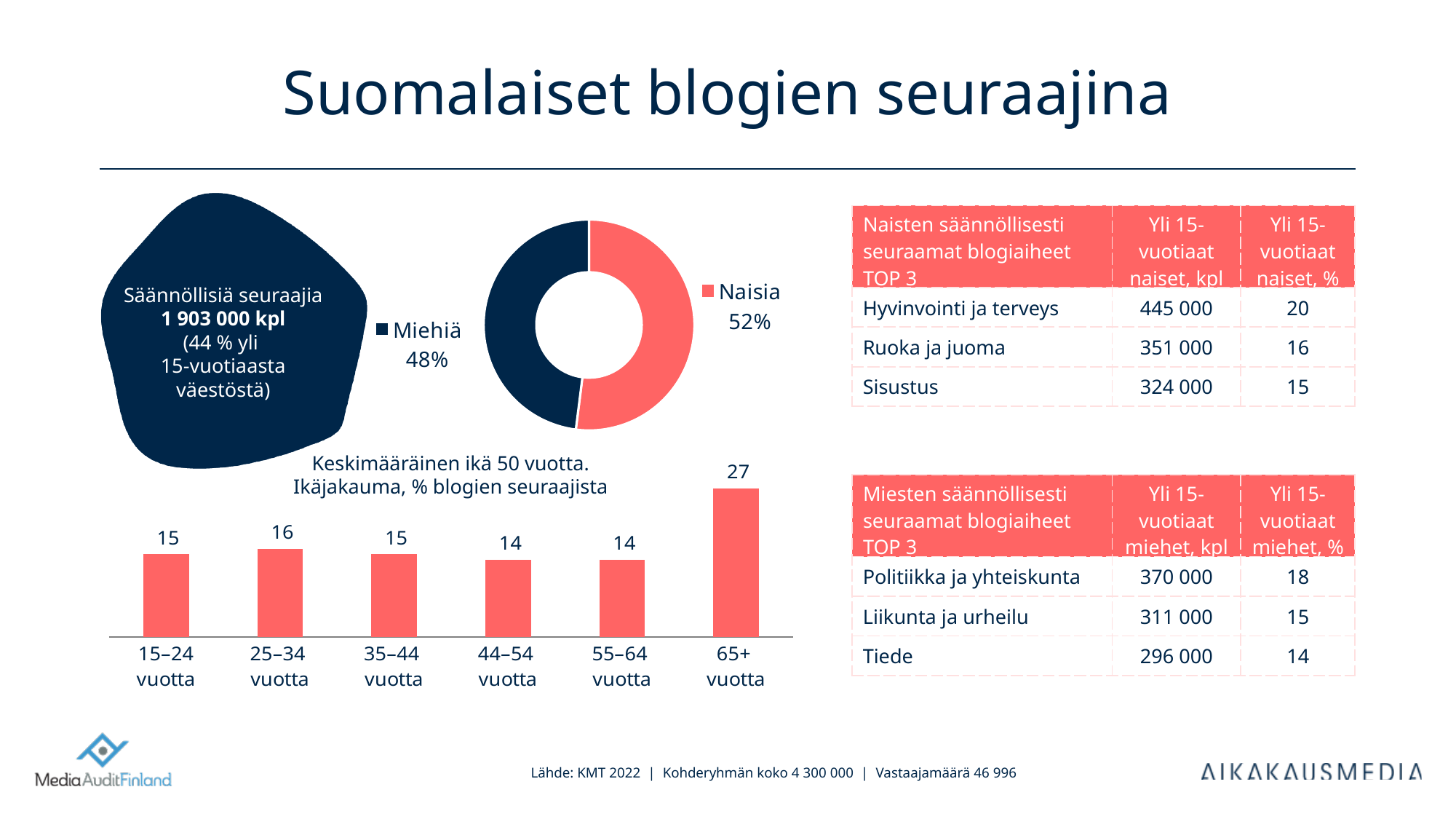
In the bar chart of age distribution, what is the difference between the values for 65+ vuotta and 15–24 vuotta? 12 In the bar chart of age distribution, which is larger, the value for 25–34 vuotta or 44–54 vuotta? 25–34 vuotta What kind of chart shows the age distribution of blog followers? Bar chart In the donut chart, which segment is larger, Miehiä or Naisia? Naisia In the donut chart, what share is labelled Miehiä? 48% How many segments does the donut chart have? 2 In the bar chart of age distribution, which age group has the highest value? 65+ vuotta In the bar chart of age distribution (Ikäjakauma, % blogien seuraajista), what is the value for 65+ vuotta? 27 What kind of chart shows the Miehiä and Naisia shares? Donut chart In the bar chart of age distribution, what is the value for 25–34 vuotta? 16 In the donut chart, what share is labelled Naisia? 52% How many age groups are shown in the bar chart of age distribution? 6